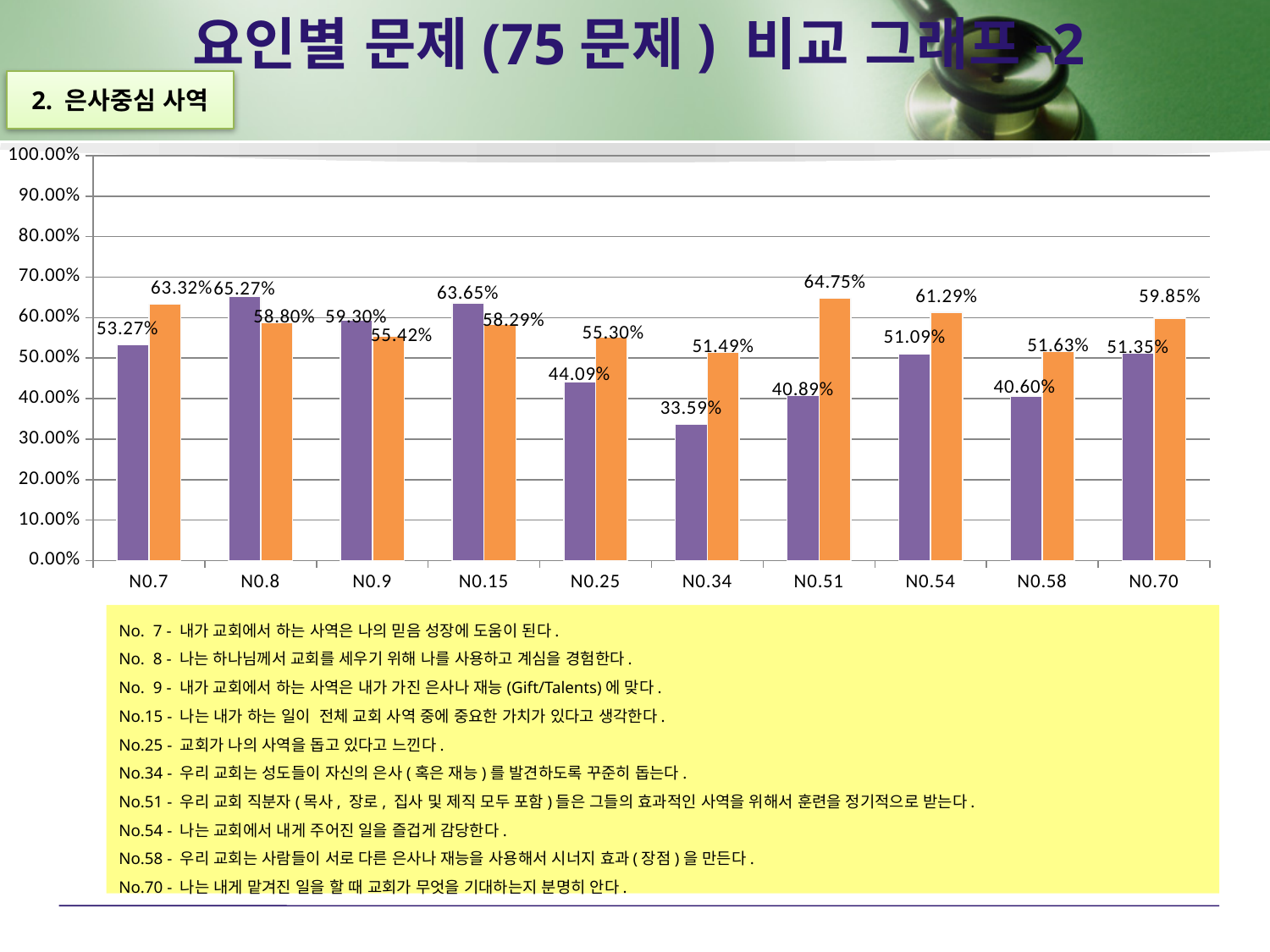
What is the value of the purple bar for N0.34? 33.59% What is the value of the purple bar for N0.7? 53.27% Which category has the highest purple bar? N0.8 What kind of chart is shown on the slide? bar chart Is the value of the purple bar for N0.34 greater or less than 40.00%? less How many categories are shown on the x axis? 10 What is the value of the orange bar for N0.70? 59.85% What is the difference between the orange and purple bars for N0.51? 23.86% What is the value of the orange bar for N0.51? 64.75% Which category has the lowest purple bar? N0.34 Which category has the highest orange bar? N0.51 For N0.8, which bar is larger, the purple or the orange? purple